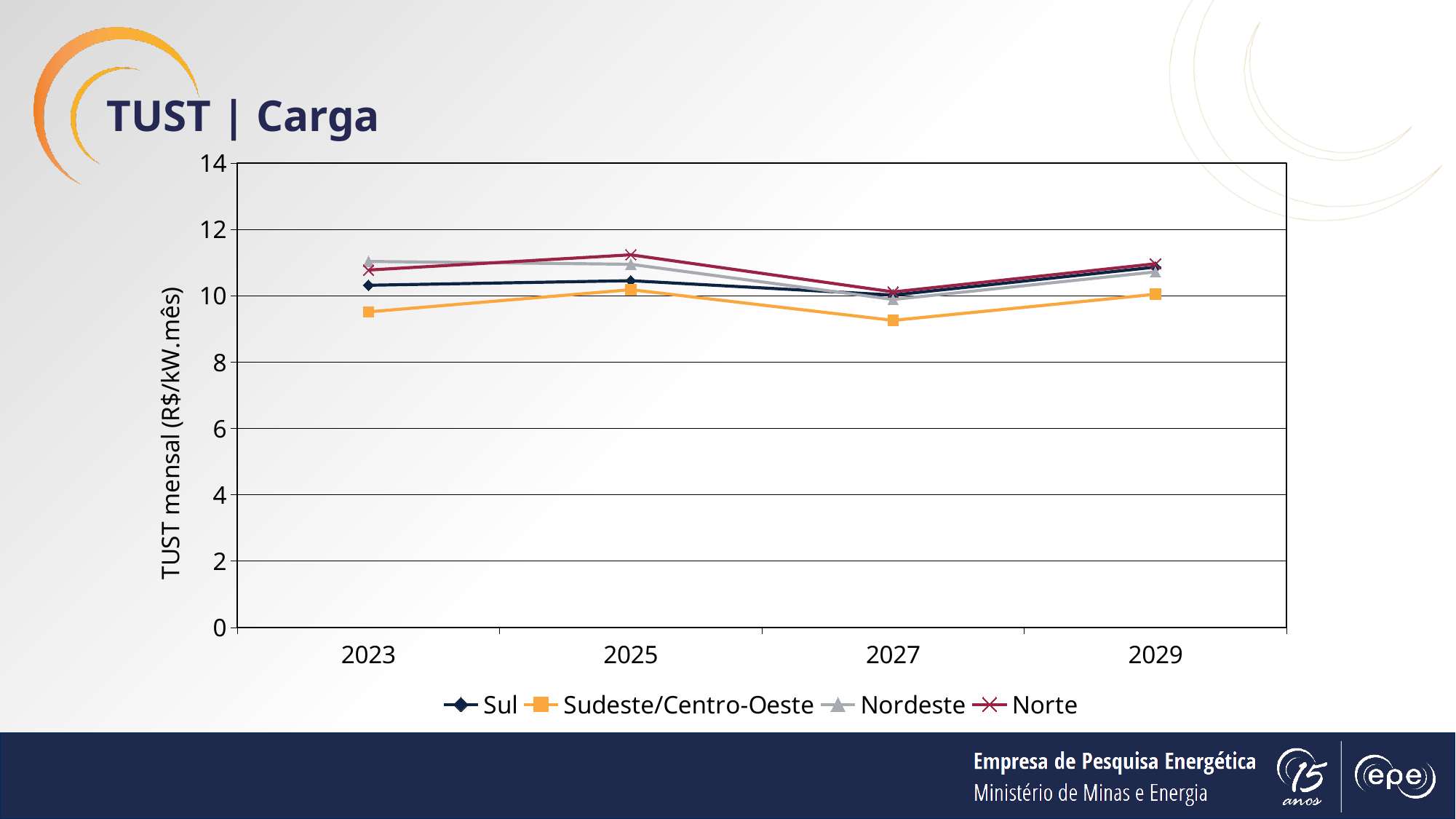
Does the value for Sudeste/Centro-Oeste rise or fall from 2025 to 2027? fall Is the value for Nordeste in 2023 greater or less than 12? less Which series has the lowest value in 2029? Sudeste/Centro-Oeste Which series has the lowest value in 2023? Sudeste/Centro-Oeste Is the value for Norte in 2025 greater or less than 10? greater What kind of chart is shown on the slide? line chart In 2023, which is larger: the value for Nordeste or the value for Sudeste/Centro-Oeste? Nordeste How many series does the legend list? 4 Is the value for Sudeste/Centro-Oeste in 2027 greater or less than 10? less How many years are shown on the x axis? 4 What is the label of the y axis? TUST mensal (R$/kW.mês) Which series has the highest value in 2025? Norte